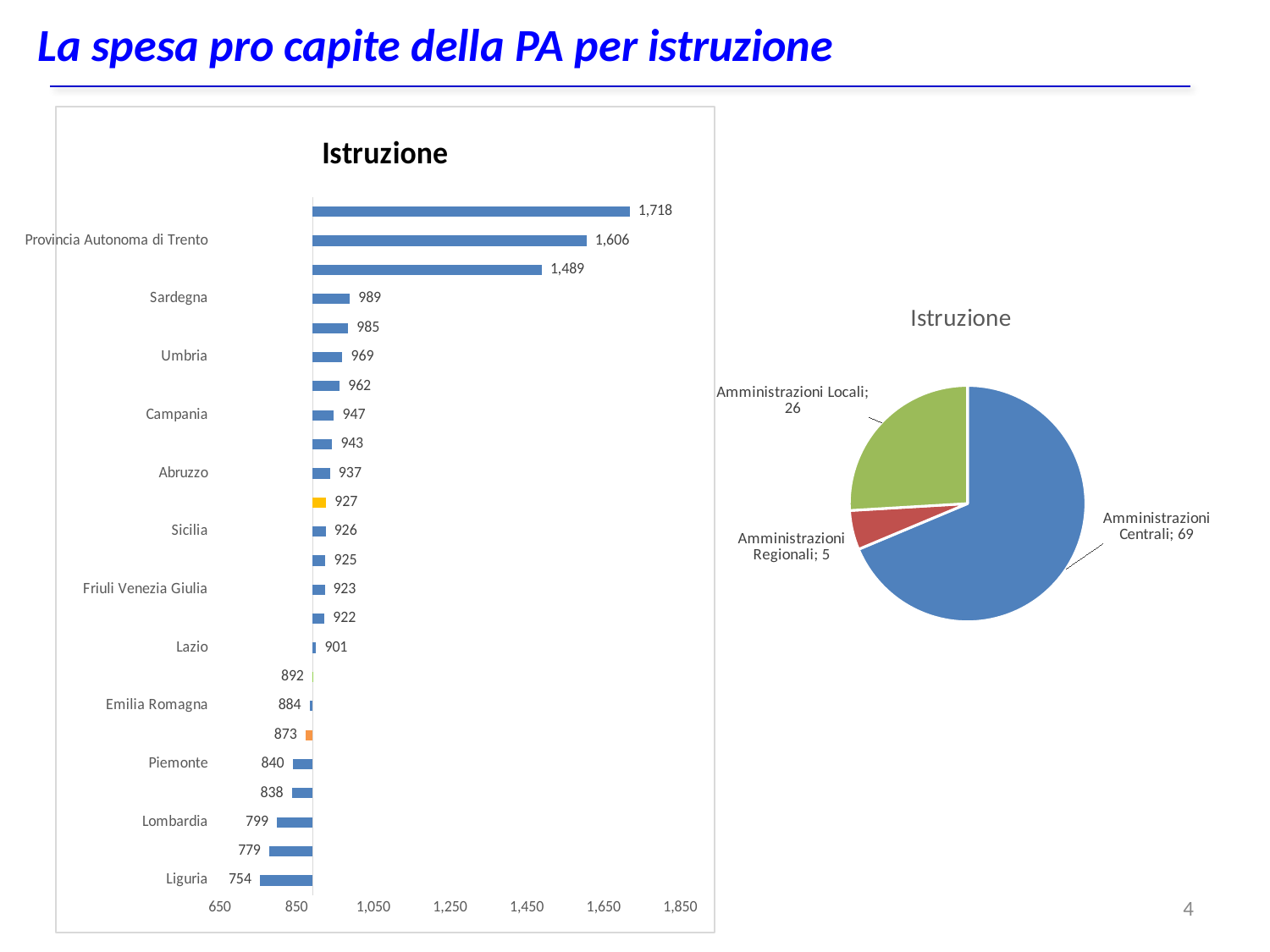
In the bar chart titled Istruzione, which labelled region has the lowest value? Liguria In the bar chart titled Istruzione, what is the difference between the values for Lombardia and Liguria? 45 In the bar chart titled Istruzione, what is the value for Provincia Autonoma di Trento? 1,606 In the bar chart titled Istruzione, which has the larger value, Umbria or Campania? Umbria How many bars are plotted in the bar chart titled Istruzione? 24 In the bar chart titled Istruzione, is the value for Piemonte greater or less than 850? less In the bar chart titled Istruzione, what is the largest value shown on any bar? 1,718 In the bar chart titled Istruzione, what is the value for Liguria? 754 In the pie chart titled Istruzione, what is the value for Amministrazioni Regionali? 5 What kind of chart is the chart on the left of the slide? bar chart In the pie chart titled Istruzione, which slice is the largest? Amministrazioni Centrali In the bar chart titled Istruzione, what is the value for Sardegna? 989